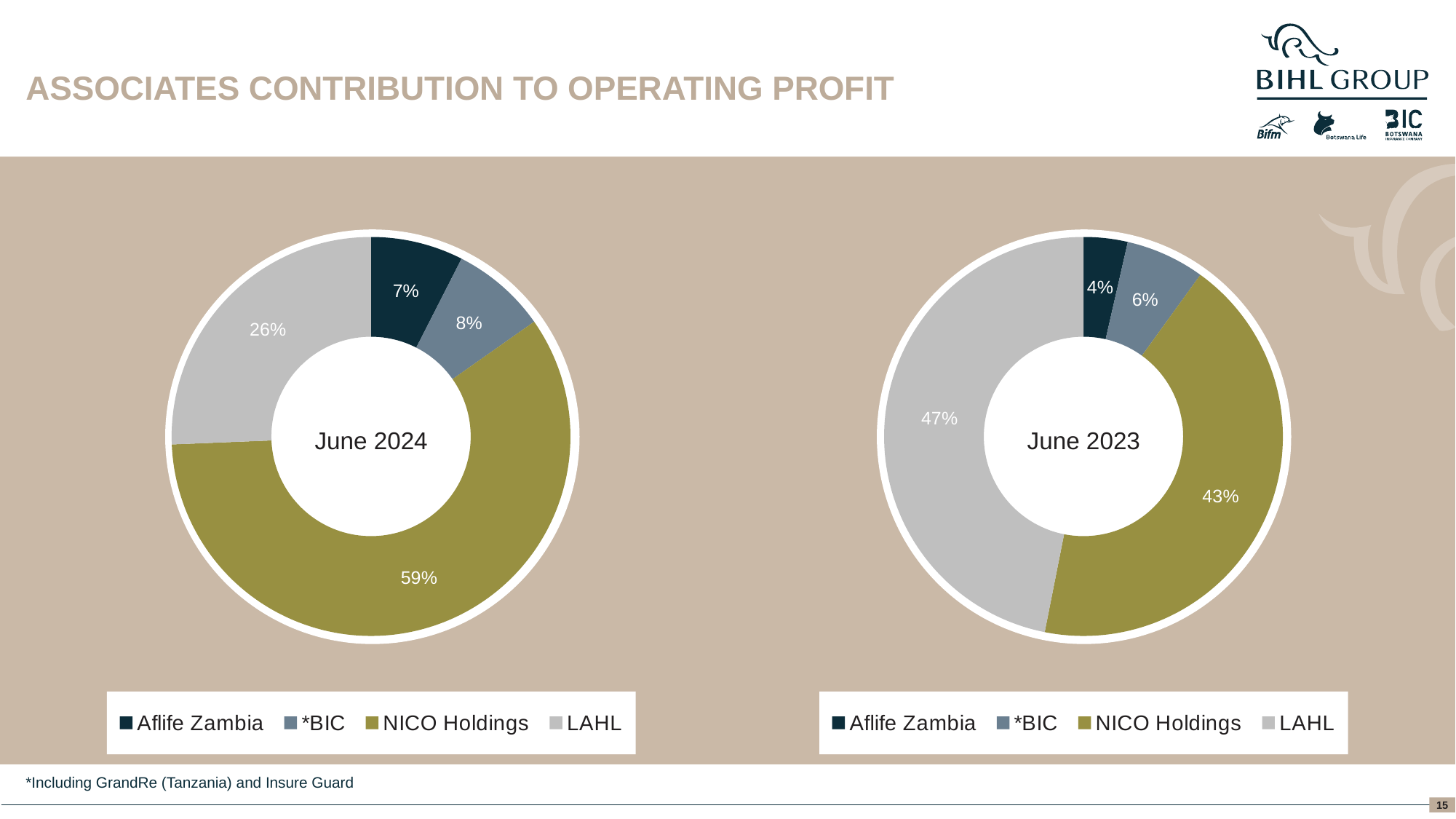
In the June 2023 chart, which associate has the smallest share? Aflife Zambia In the June 2024 chart, which associate has the largest share? NICO Holdings In the June 2023 chart, which is larger: the LAHL share or the NICO Holdings share? LAHL In the June 2023 chart, what is the value for *BIC? 6% What is the title of the slide containing the two charts? ASSOCIATES CONTRIBUTION TO OPERATING PROFIT What type of chart is used for June 2023? Doughnut (pie) chart What is the difference between the Aflife Zambia share in June 2024 and in June 2023? 3% In the June 2024 chart, what share does NICO Holdings contribute? 59% How many categories are shown in the June 2024 chart? 4 In the June 2023 chart, what share does LAHL contribute? 47% In the June 2024 chart, what is the difference between the NICO Holdings share and the LAHL share? 33% In the June 2024 chart, what is the value for Aflife Zambia? 7%